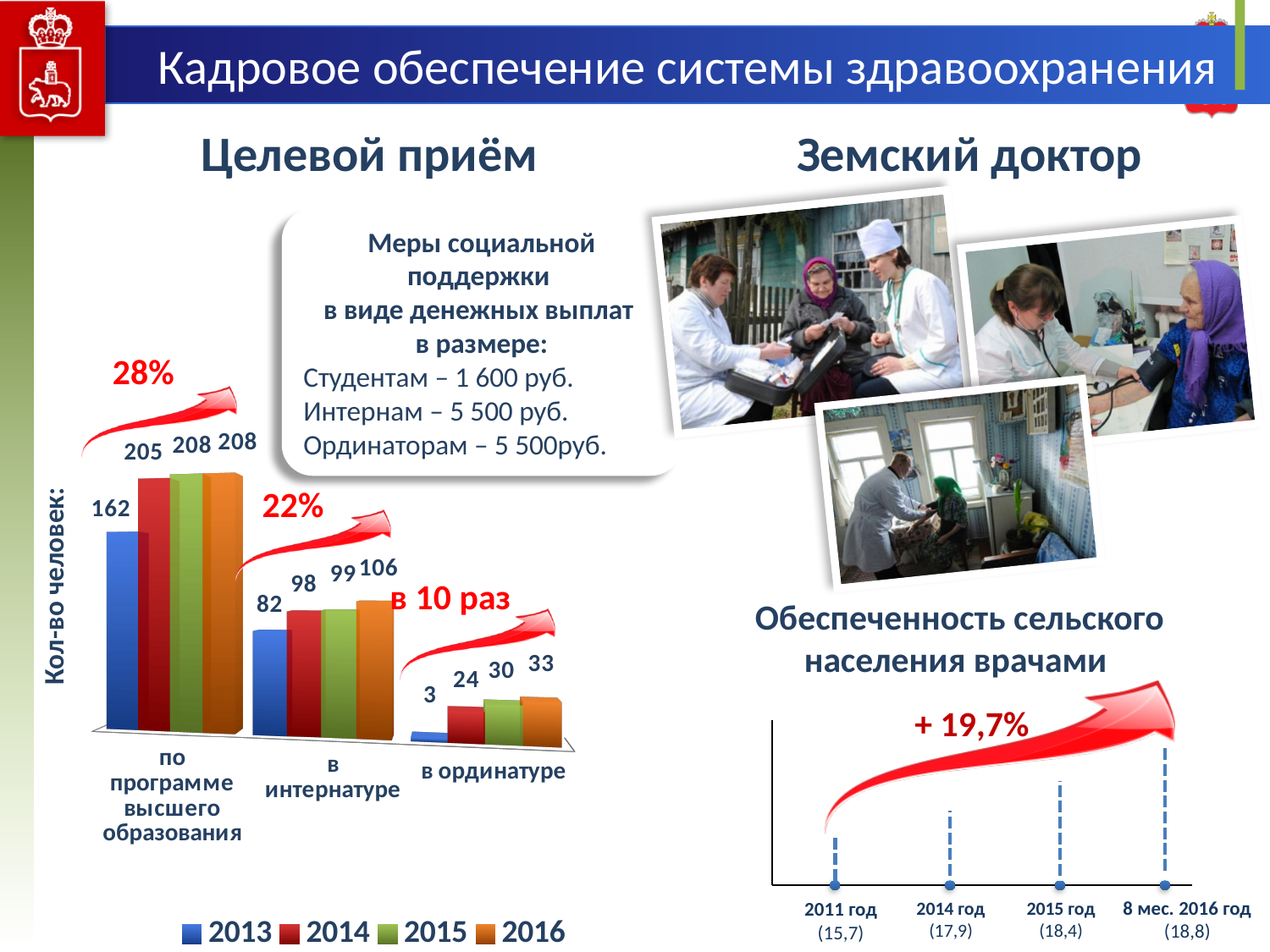
On the 'Целевой приём' bar chart, what is the value for 2013 in the category 'в ординатуре'? 3 On the 'Целевой приём' bar chart, what is the value for 2013 in the category 'по программе высшего образования'? 162 What kind of chart is the 'Целевой приём' chart? bar chart On the 'Целевой приём' bar chart, what is the difference between the 2016 and 2013 values in the category 'в интернатуре'? 24 On the 'Целевой приём' bar chart, which is larger: the 2014 value for 'по программе высшего образования' or the 2014 value for 'в интернатуре'? по программе высшего образования On the 'Целевой приём' bar chart, what is the value for 2016 in the category 'в интернатуре'? 106 On the 'Целевой приём' bar chart, which year has the lowest value in the category 'в ординатуре'? 2013 On the 'Обеспеченность сельского населения врачами' chart, what is the value for 2011 год? 15,7 How many categories are shown on the x axis of the 'Целевой приём' chart? 3 On the 'Целевой приём' bar chart, do the values in the category 'в ординатуре' rise or fall from 2013 to 2016? rise On the 'Обеспеченность сельского населения врачами' chart, what is the value for 8 мес. 2016 год? 18,8 How many series does the legend of the 'Целевой приём' bar chart list? 4